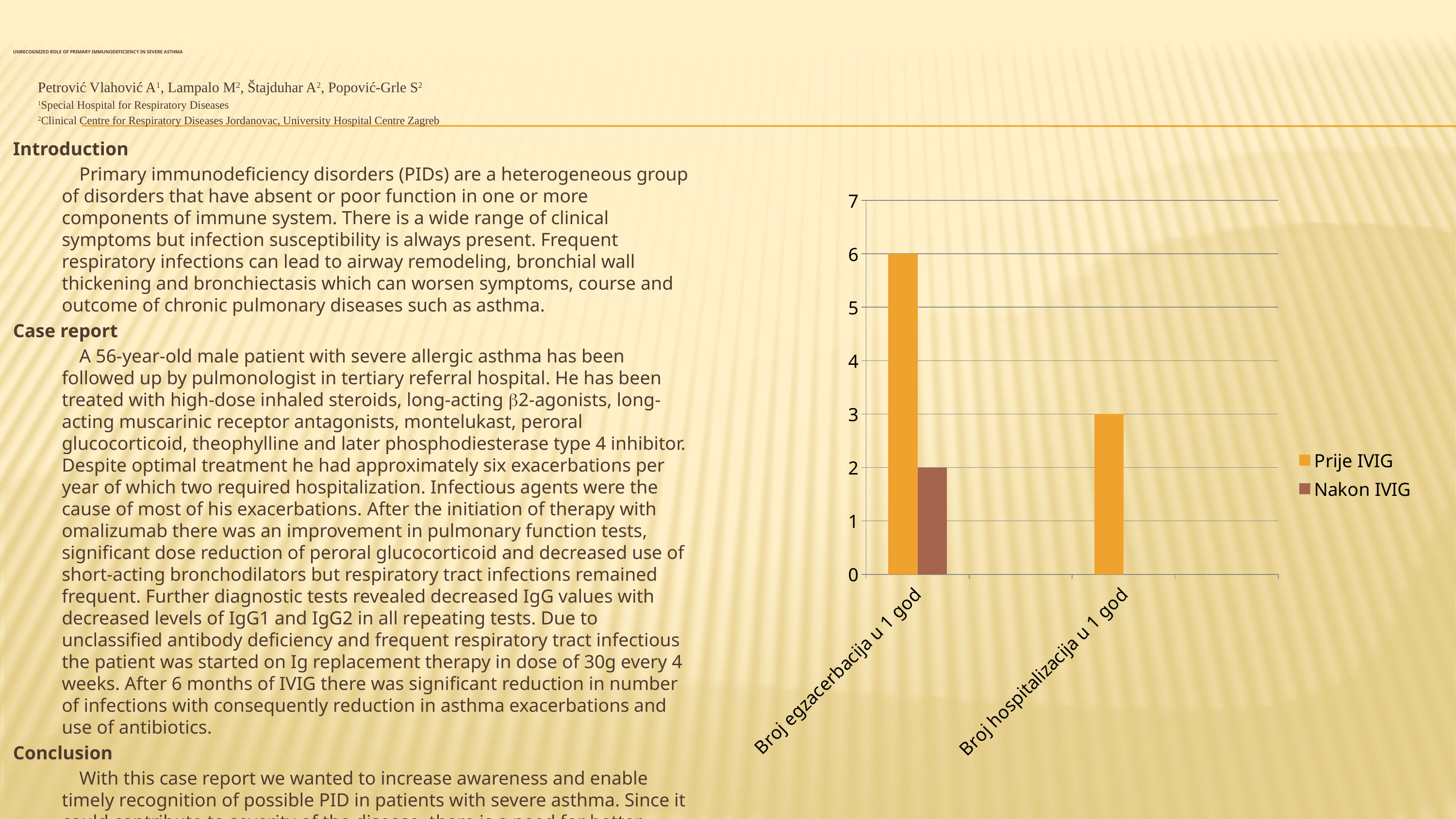
What is the difference between Prije IVIG and Nakon IVIG for Broj egzacerbacija u 1 god? 4 What kind of chart is shown on the slide? bar chart Which is larger for Broj egzacerbacija u 1 god, Prije IVIG or Nakon IVIG? Prije IVIG What is the value of Nakon IVIG for Broj egzacerbacija u 1 god? 2 How many categories are shown on the x axis? 2 Which category has the highest Prije IVIG value? Broj egzacerbacija u 1 god What is the value of Prije IVIG for Broj hospitalizacija u 1 god? 3 What colour are the Prije IVIG bars? orange What is the value of Prije IVIG for Broj egzacerbacija u 1 god? 6 Is the Prije IVIG value for Broj egzacerbacija u 1 god greater or less than 5? greater How many series does the legend list? 2 What is the difference between the Prije IVIG values for Broj egzacerbacija u 1 god and Broj hospitalizacija u 1 god? 3